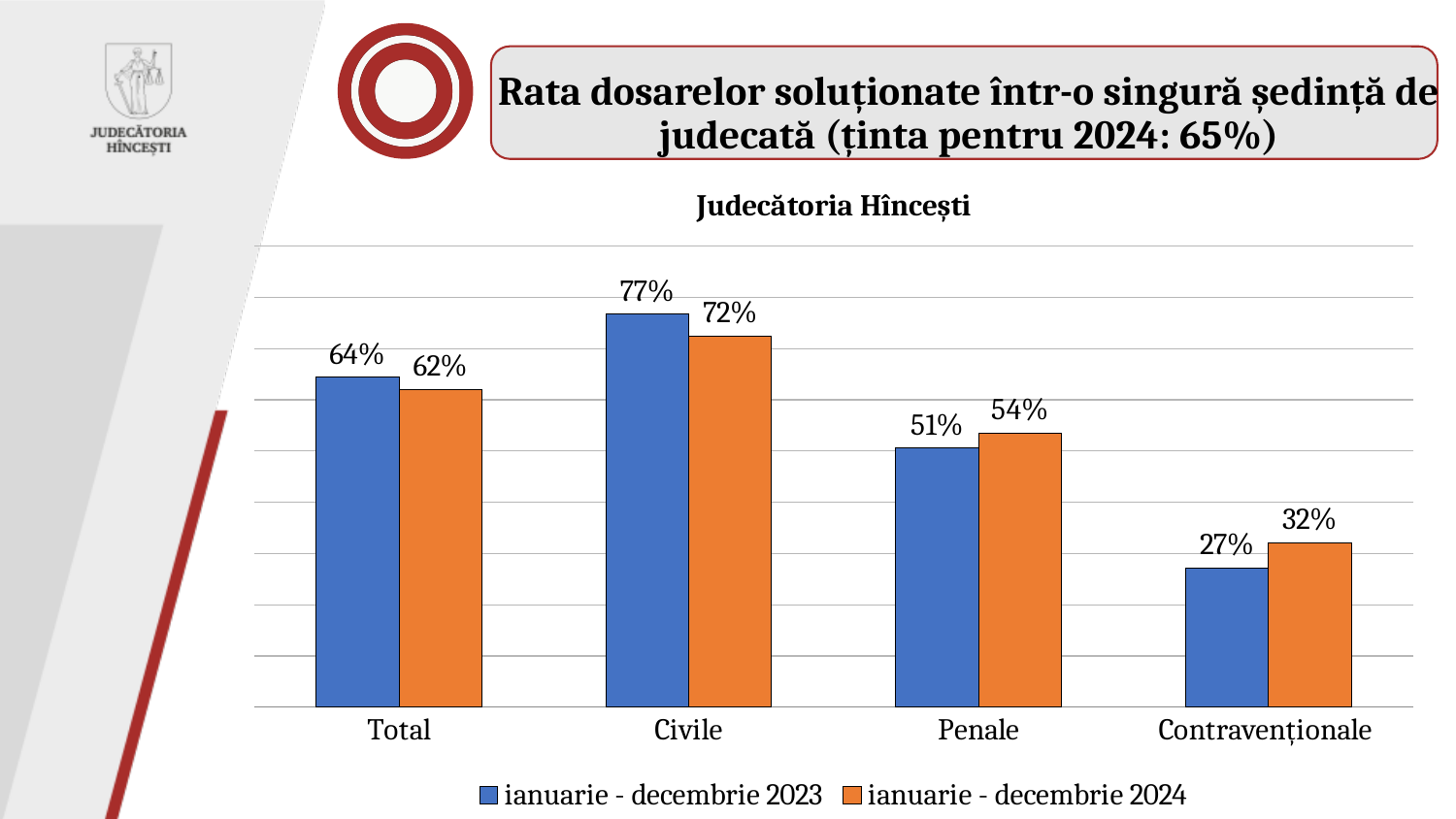
Which category has the lowest value in the ianuarie - decembrie 2024 series? Contravenționale How many categories are shown on the x axis? 4 What is the value for Penale in the ianuarie - decembrie 2024 series? 54% What is the difference between the 2023 and 2024 values for Civile? 5% What is the value for Contravenționale in the ianuarie - decembrie 2024 series? 32% How many series does the legend list? 2 For Penale, which series has the larger value: ianuarie - decembrie 2023 or ianuarie - decembrie 2024? ianuarie - decembrie 2024 What is the value for Civile in the ianuarie - decembrie 2023 series? 77% What kind of chart is shown on the slide? bar chart Which category has the highest value in the ianuarie - decembrie 2023 series? Civile What is the difference between the 2024 and 2023 values for Contravenționale? 5% What is the title of the chart? Judecătoria Hîncești